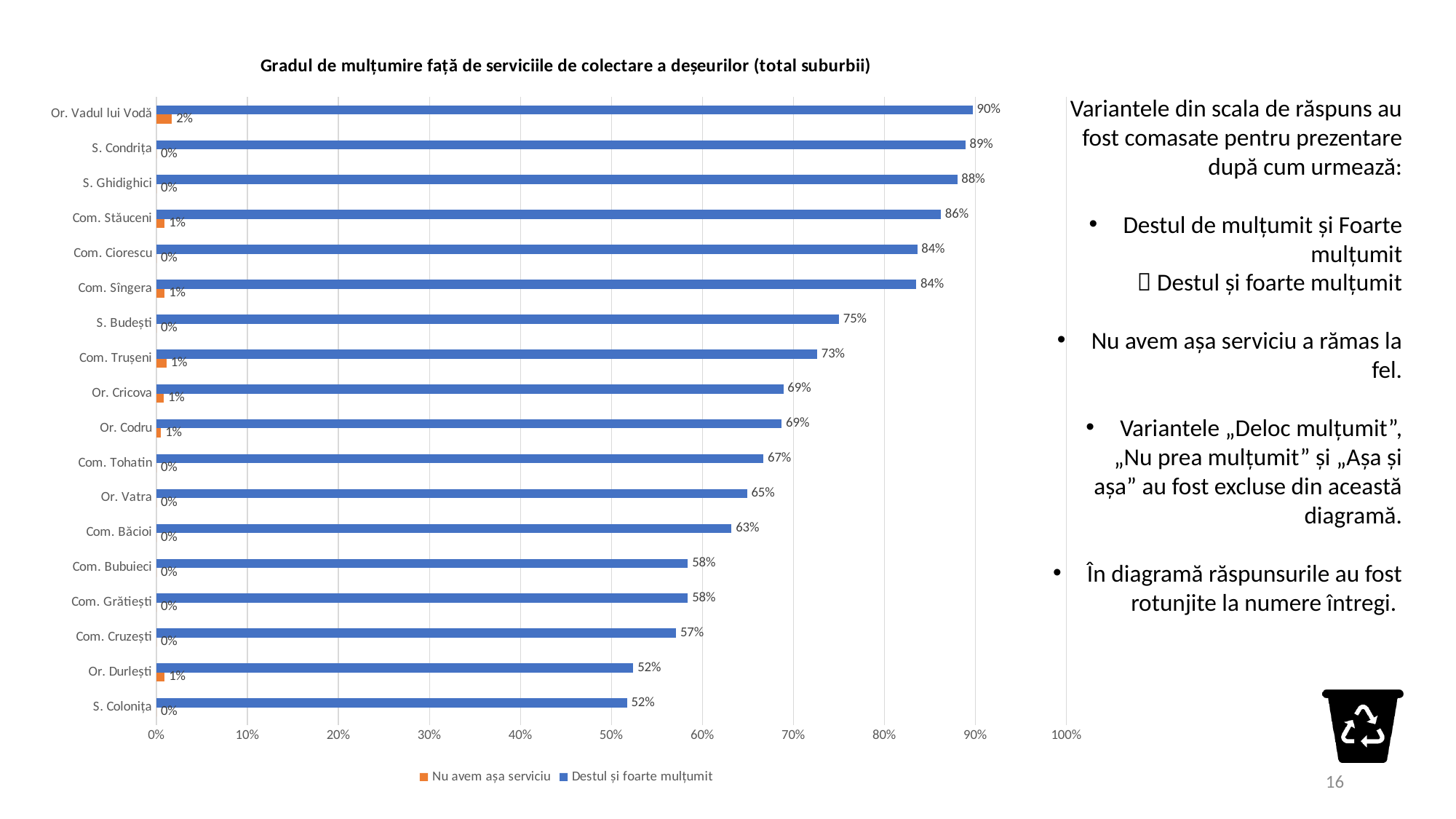
What type of chart is shown on the slide? Bar chart What is the difference between the "Destul și foarte mulțumit" values for S. Budești and Com. Trușeni? 2 percentage points How many localities are shown on the chart? 18 How many series does the legend list? 2 What is the value of "Destul și foarte mulțumit" for Com. Trușeni? 73% What is the value of "Nu avem așa serviciu" for Or. Vadul lui Vodă? 2% What is the title of the chart? Gradul de mulțumire față de serviciile de colectare a deșeurilor (total suburbii) Which locality has the highest value for "Destul și foarte mulțumit"? Or. Vadul lui Vodă What is the difference between the "Destul și foarte mulțumit" values for Or. Vadul lui Vodă and S. Colonița? 38 percentage points What is the value of "Destul și foarte mulțumit" for S. Colonița? 52% Which has a higher "Destul și foarte mulțumit" value, Com. Stăuceni or Or. Vatra? Com. Stăuceni What is the value of "Destul și foarte mulțumit" for Or. Vadul lui Vodă? 90%